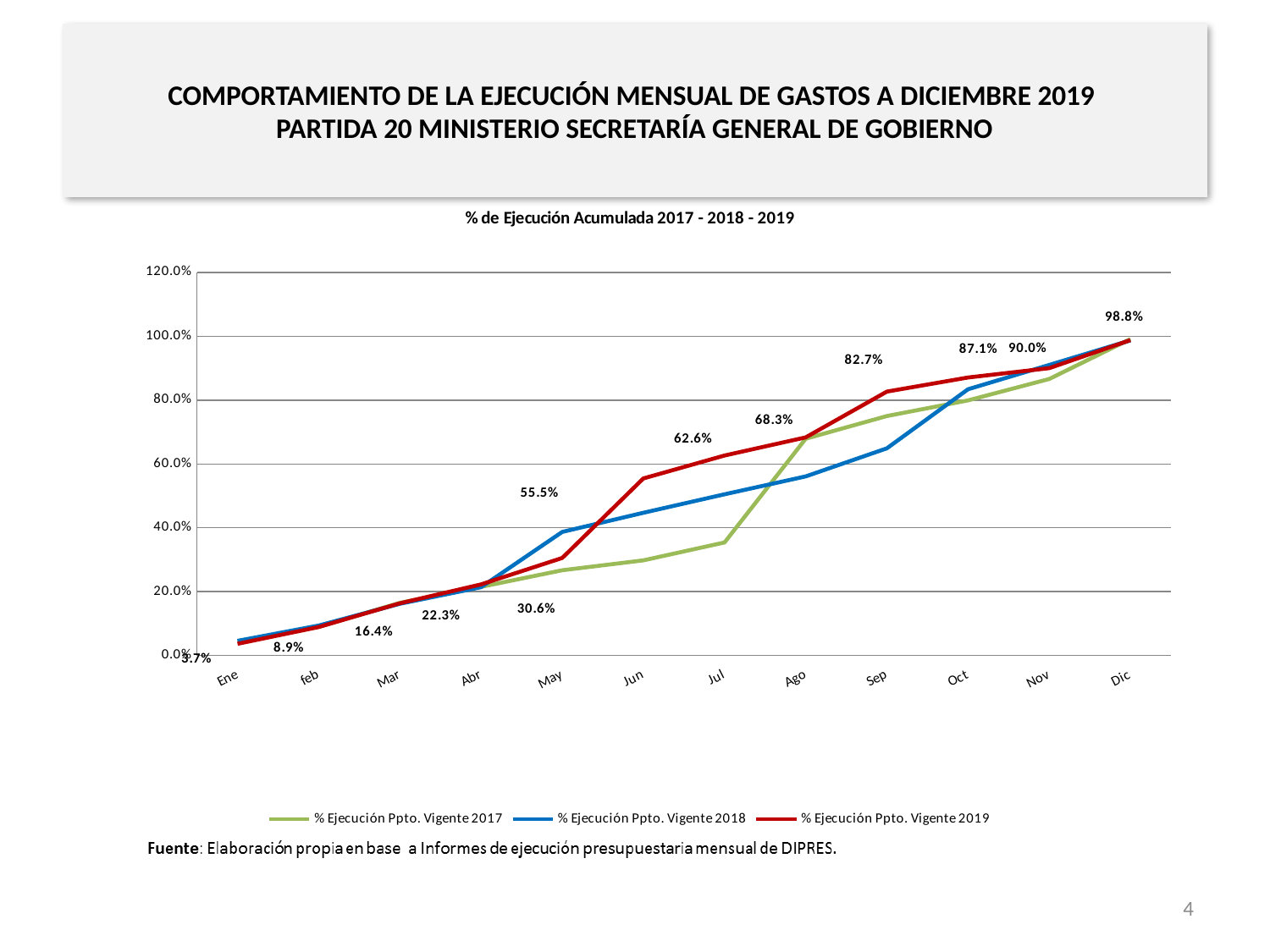
What is the difference between the 2019 values for Dic and Nov? 8.8% What is the % Ejecución Ppto. Vigente 2019 value for Jun? 55.5% How many months are shown on the x axis? 12 In which month is the % Ejecución Ppto. Vigente 2019 value lowest? Ene How many series does the legend list? 3 What is the difference between the 2019 values for Jun and May? 24.9% Is the % Ejecución Ppto. Vigente 2017 value for Jul greater or less than 40.0%? less What is the % Ejecución Ppto. Vigente 2019 value for Mar? 16.4% What is the % Ejecución Ppto. Vigente 2019 value for Dic? 98.8% What is the % Ejecución Ppto. Vigente 2019 value for Sep? 82.7% In Jul, which series has the larger value: % Ejecución Ppto. Vigente 2018 or % Ejecución Ppto. Vigente 2017? % Ejecución Ppto. Vigente 2018 What kind of chart is shown on the slide? Line chart